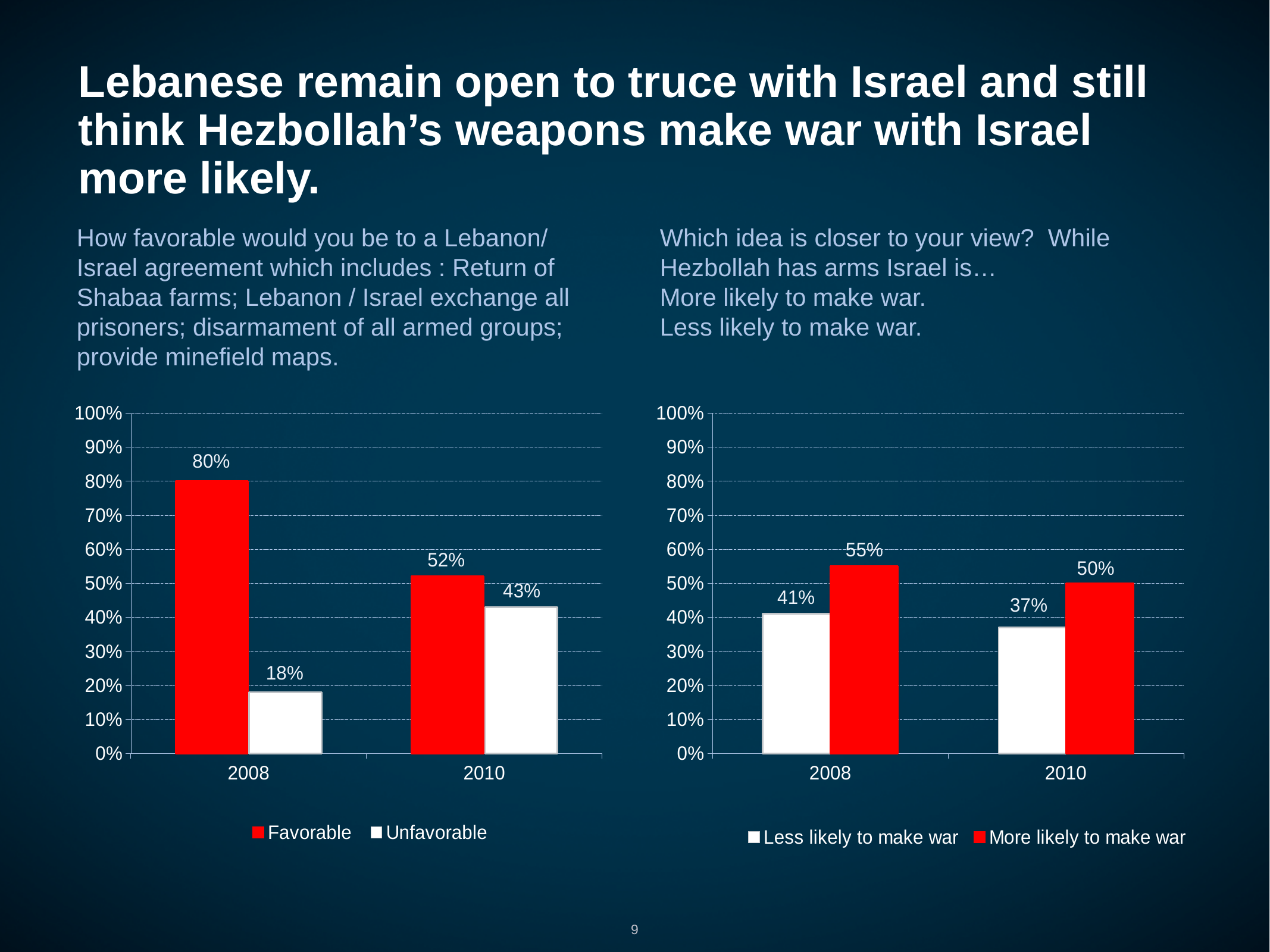
In the right chart (Hezbollah arms and likelihood of war), what is the difference between 'More likely to make war' and 'Less likely to make war' in 2008? 14 percentage points In the left chart (Lebanon/Israel agreement favorability), by how many percentage points did the Favorable value fall from 2008 to 2010? 28 percentage points In the right chart (Hezbollah arms and likelihood of war), what is the 'More likely to make war' value for 2008? 55% In the right chart (Hezbollah arms and likelihood of war), what colour are the 'More likely to make war' bars? red In the left chart (Lebanon/Israel agreement favorability), what is the Unfavorable value for 2010? 43% In the right chart (Hezbollah arms and likelihood of war), what is the 'Less likely to make war' value for 2010? 37% In the right chart (Hezbollah arms and likelihood of war), which is larger in 2010: 'Less likely to make war' or 'More likely to make war'? More likely to make war In the left chart (Lebanon/Israel agreement favorability), how many series does the legend list? 2 In the left chart (Lebanon/Israel agreement favorability), what is the Favorable value for 2008? 80% What kind of chart is the right chart (Hezbollah arms and likelihood of war)? bar chart In the left chart (Lebanon/Israel agreement favorability), which year has the lowest Unfavorable value? 2008 In the left chart (Lebanon/Israel agreement favorability), does the Favorable value rise or fall from 2008 to 2010? fall